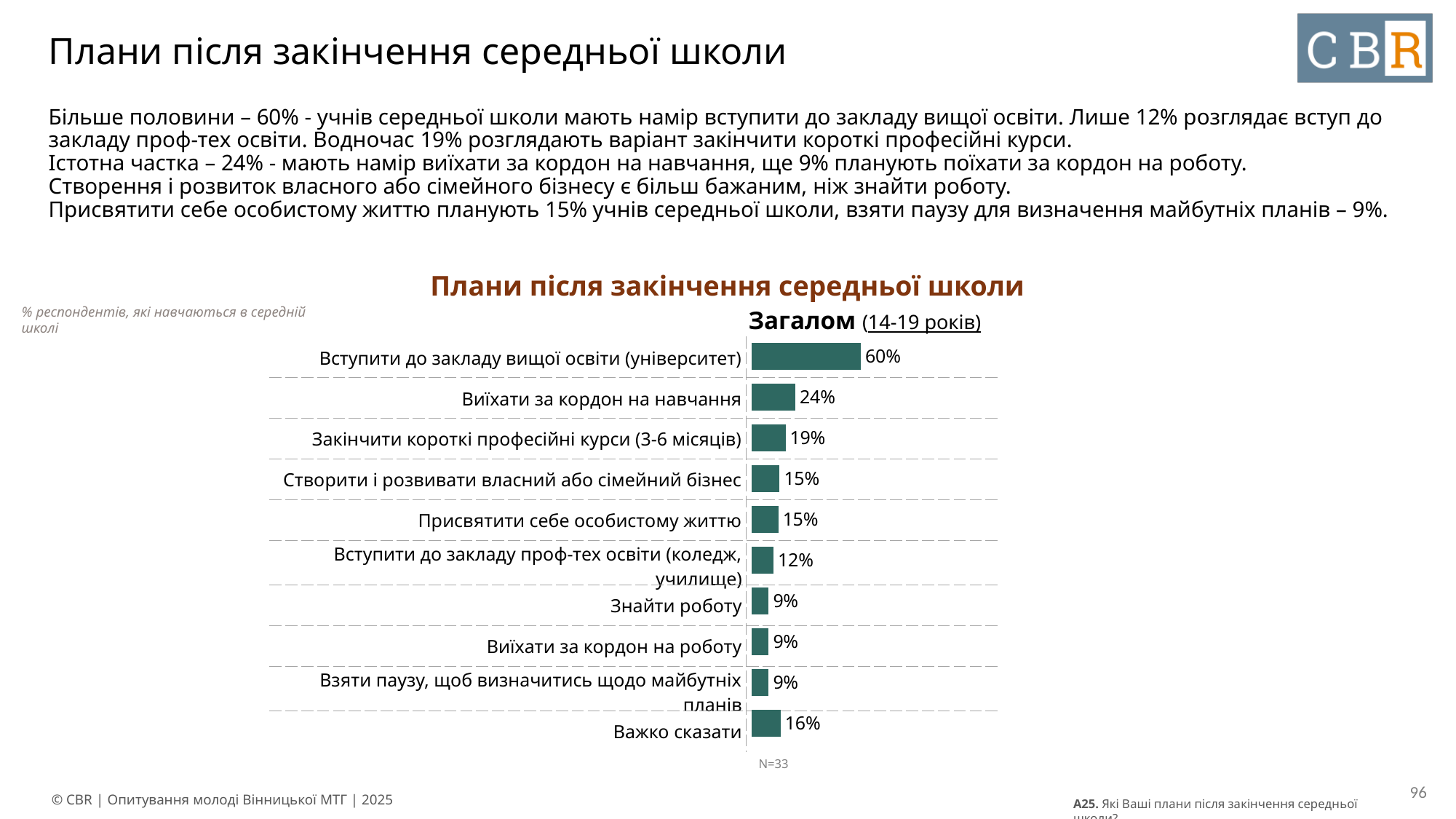
What is the value for "Виїхати за кордон на навчання"? 24% What is the value for "Вступити до закладу проф-тех освіти (коледж, училище)"? 12% Which is larger: "Створити і розвивати власний або сімейний бізнес" or "Знайти роботу"? Створити і розвивати власний або сімейний бізнес Which category has the highest value? Вступити до закладу вищої освіти (університет) What is the value for "Важко сказати"? 16% What is the difference between "Вступити до закладу вищої освіти (університет)" and "Виїхати за кордон на навчання"? 36% What is the title of the chart? Плани після закінчення середньої школи What type of chart is shown on the slide? bar chart What is the value for "Закінчити короткі професійні курси (3-6 місяців)"? 19% How many categories are shown in the chart? 10 What is the difference between "Виїхати за кордон на навчання" and "Виїхати за кордон на роботу"? 15% What is the value for "Вступити до закладу вищої освіти (університет)"? 60%